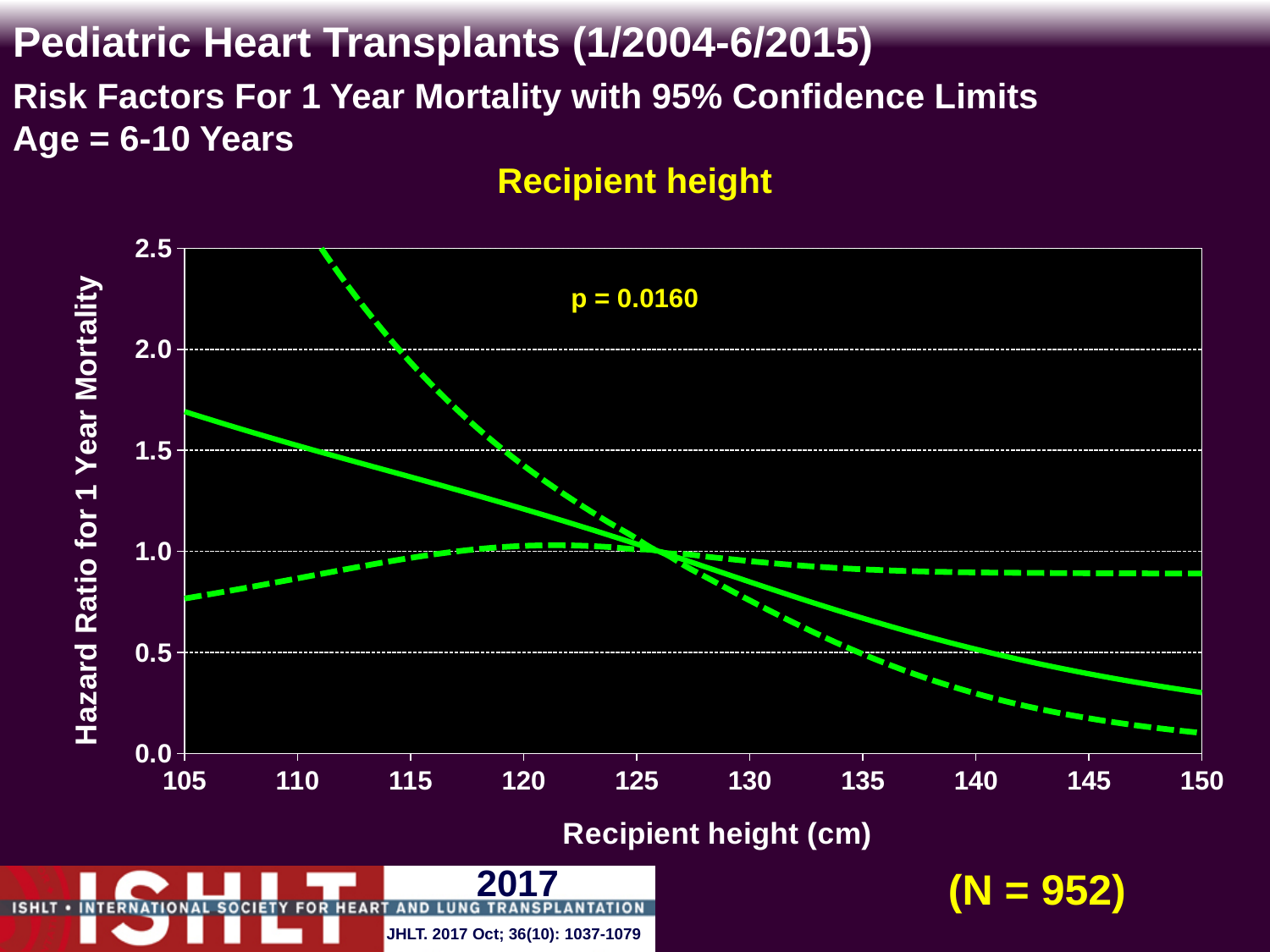
Is the hazard ratio on the solid line at a recipient height of 135 cm greater or less than 1.0? less What sample size (N) is shown on the slide? N = 952 Is the hazard ratio on the solid line at a recipient height of 105 cm greater or less than 1.5? greater How many tick labels are shown on the x axis of the chart? 10 What kind of chart is shown on the slide? line chart What p-value is printed on the chart? p = 0.0160 Is the hazard ratio on the solid line at a recipient height of 115 cm greater or less than 1.0? greater How does the solid hazard ratio line change as recipient height increases from 105 cm to 150 cm? It falls How many lines are plotted on the chart? 3